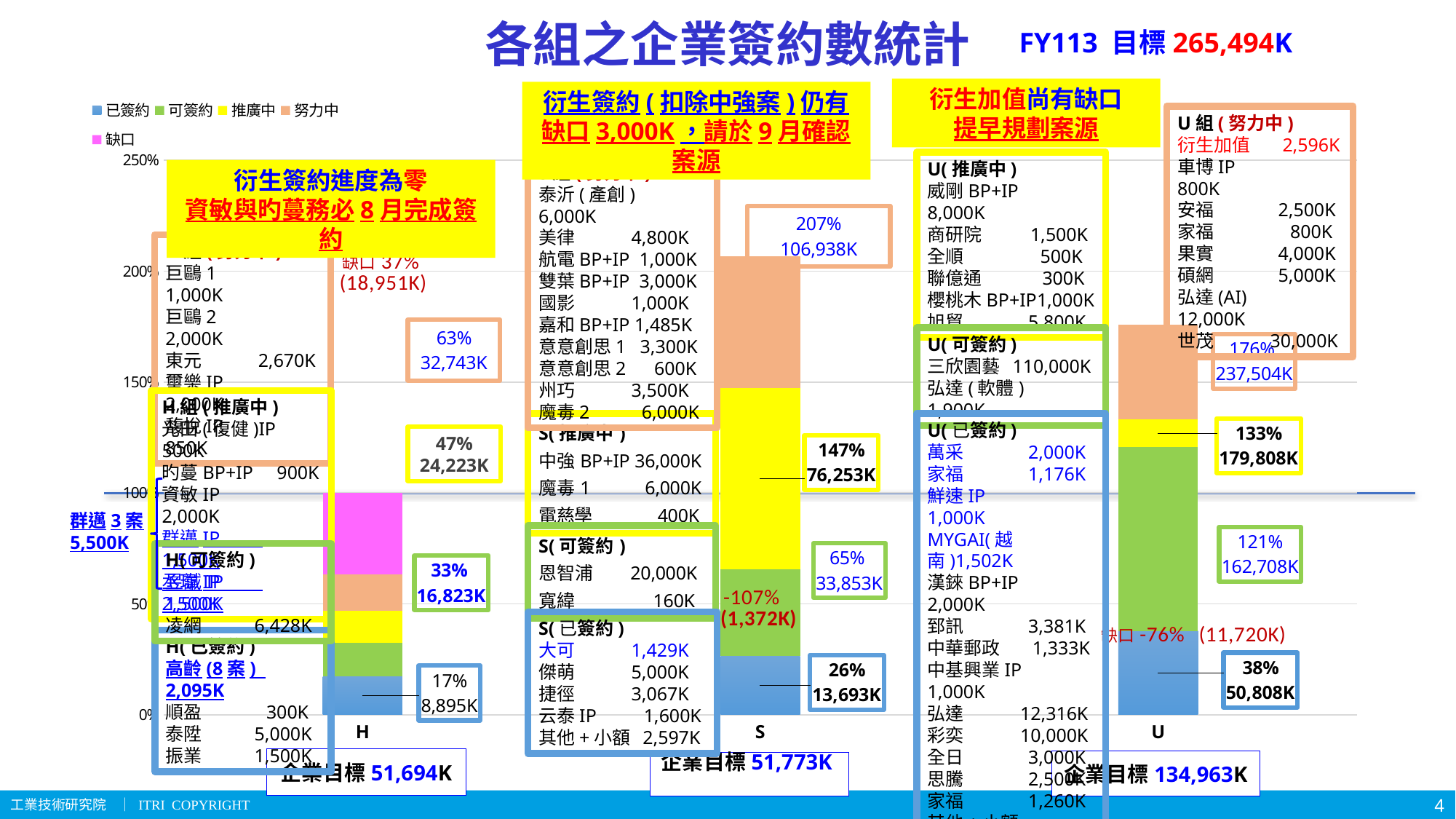
What kind of chart is shown on the slide? bar chart What amount in K is labeled for the 已簽約 (signed) segment of group S? 13,693K How many categories (groups) are shown on the x axis of the chart? 3 Which group has the lowest 已簽約 (signed) percentage? H What is the FY113 target shown at the top of the slide? 265,494K What percentage is labeled for the 已簽約 (signed) segment of group H? 17% How many series does the chart legend list? 5 Which group has the highest 已簽約 (signed) amount in K? U Which is larger, the 已簽約 percentage for group S or for group U? U What amount in K is labeled for the 已簽約 (signed) segment of group U? 50,808K What percentage is labeled for the 可簽約 level of group U? 121% What is the 企業目標 (enterprise target) shown for group U? 134,963K